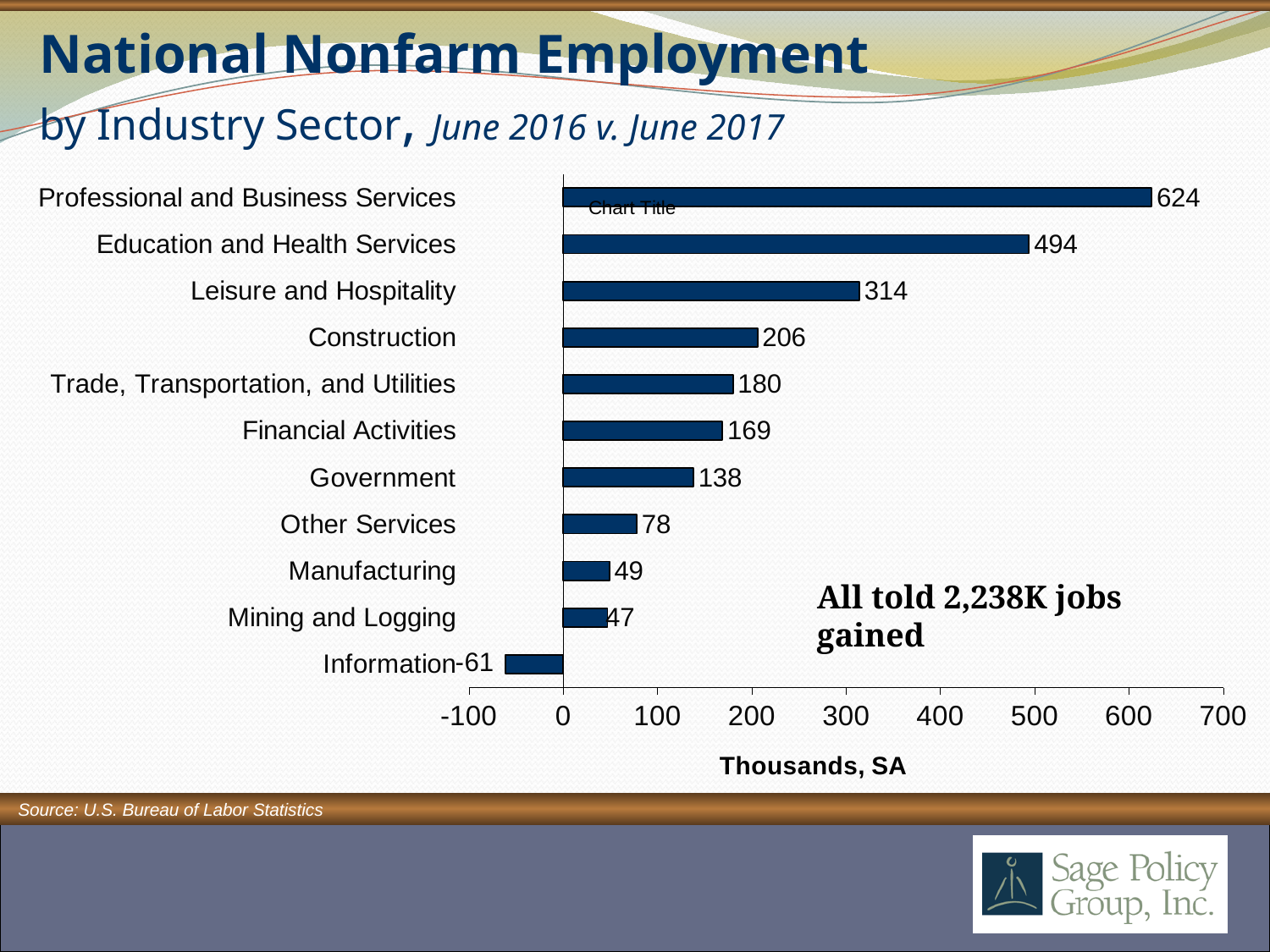
What unit label is shown on the x axis of the chart? Thousands, SA What kind of chart is shown on the slide? Bar chart What is the value for Professional and Business Services? 624 Which is larger, Construction or Trade, Transportation, and Utilities? Construction What is the difference between Education and Health Services and Leisure and Hospitality? 180 What is the value for Mining and Logging? 47 What is the value for Information? -61 Which industry sector has the highest value? Professional and Business Services What is the difference between Manufacturing and Mining and Logging? 2 How many industry sectors are shown in the chart? 11 What is the value for Government? 138 Which industry sector has the lowest value? Information